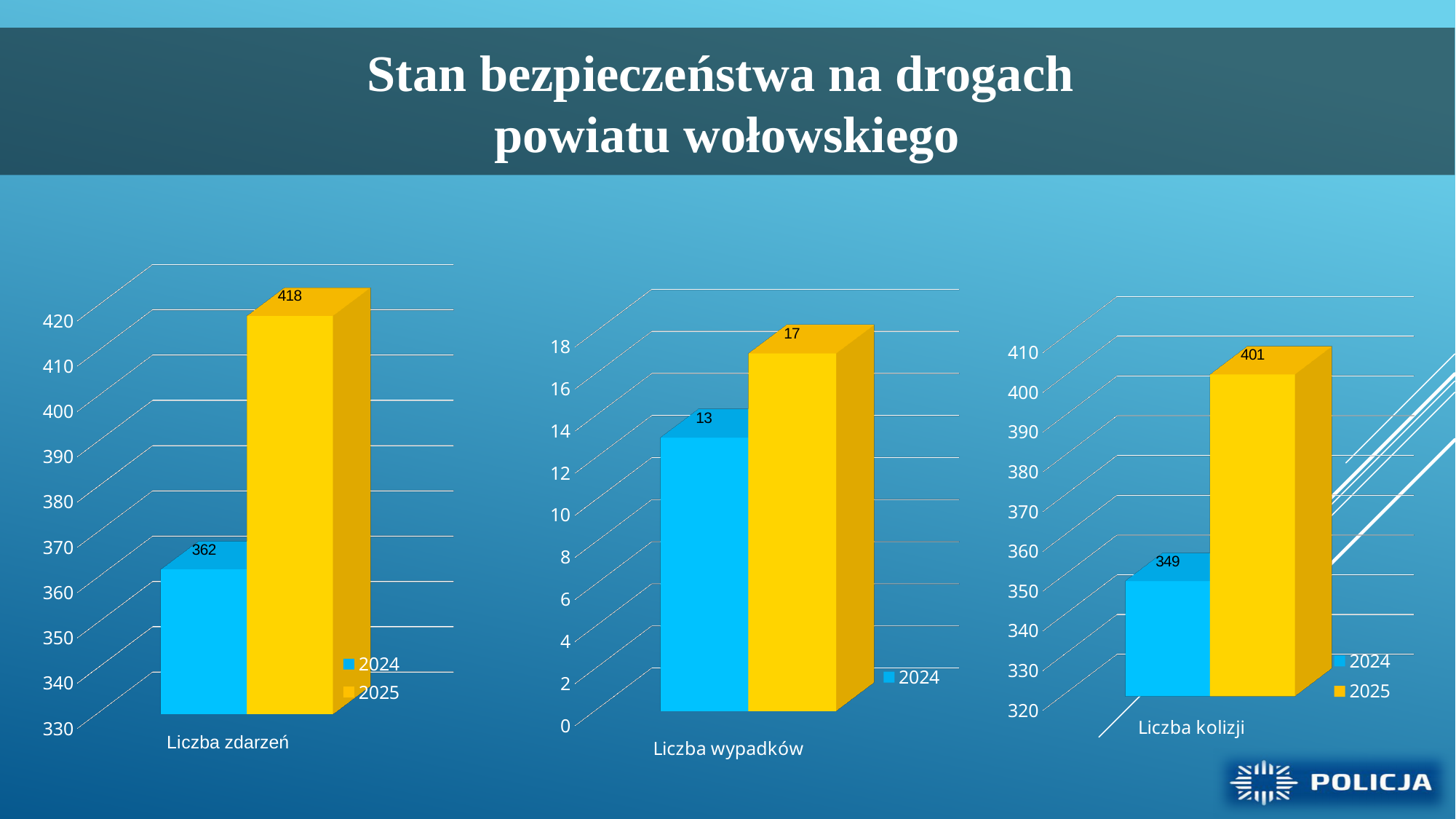
In the right chart (Liczba kolizji), what is the difference between the 2025 and 2024 values? 52 In the left chart (Liczba zdarzeń), what is the value for 2025? 418 In the middle chart (Liczba wypadków), which bar is higher, the blue one or the yellow one? the yellow one In the left chart (Liczba zdarzeń), what is the value for 2024? 362 How many series does the legend of the right chart (Liczba kolizji) list? 2 In the right chart (Liczba kolizji), what is the value for 2025? 401 In the left chart (Liczba zdarzeń), what is the difference between the 2025 and 2024 values? 56 What kind of chart is the left chart (Liczba zdarzeń)? bar chart In the left chart (Liczba zdarzeń), which series has the highest value? 2025 In the middle chart (Liczba wypadków), what is the value for 2024? 13 In the right chart (Liczba kolizji), what is the value for 2024? 349 In the middle chart (Liczba wypadków), what is the value for the yellow bar? 17